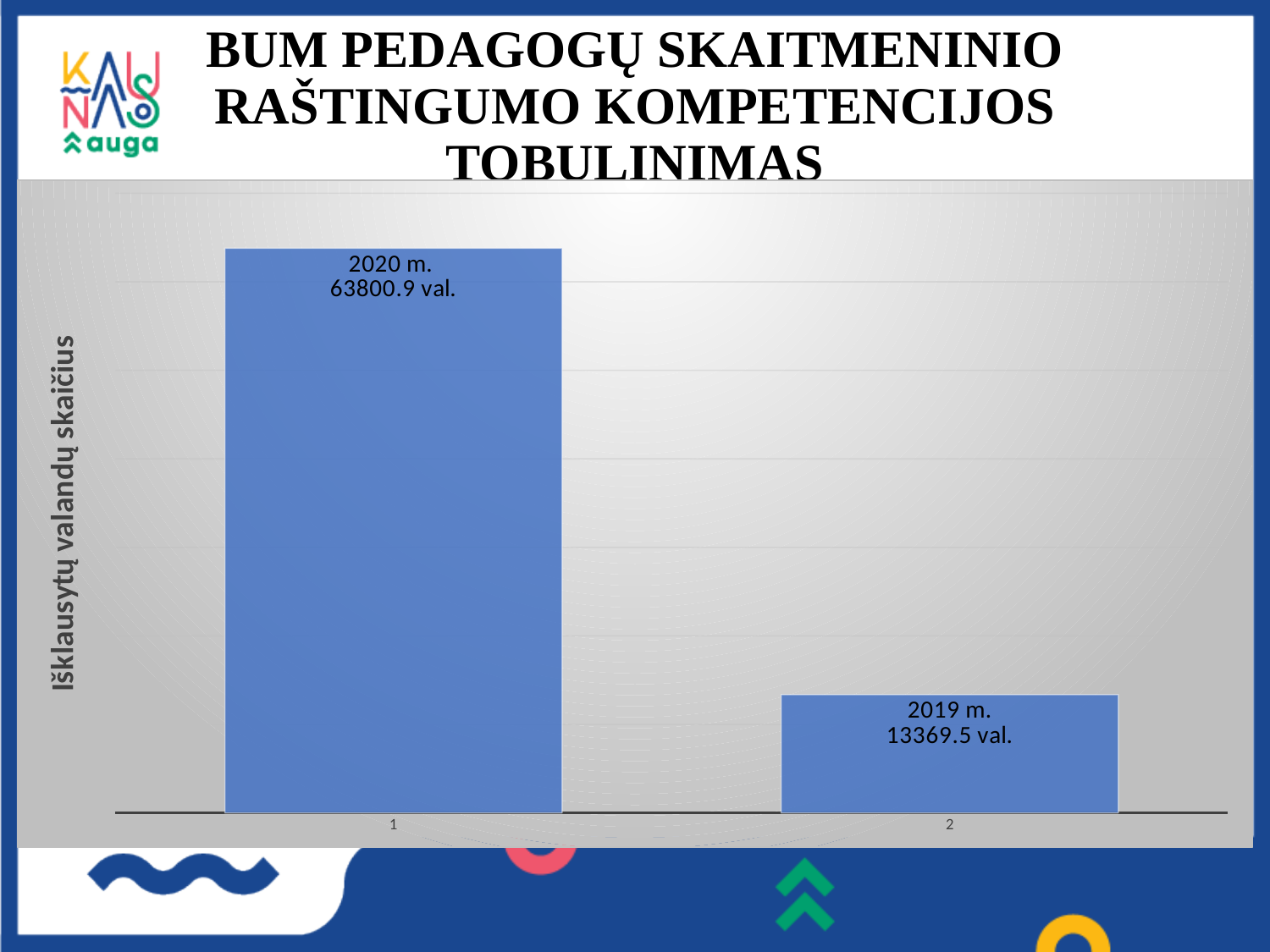
What is the label of the vertical axis? Išklausytų valandų skaičius Which is larger, the value for 2020 m. or the value for 2019 m.? 2020 m. Which year has the highest number of hours listened? 2020 m. What colour are the bars in the chart? Blue What is the value shown for 2019 m.? 13369.5 val. How many bars are plotted in the chart? 2 What is the value shown for 2020 m.? 63800.9 val. What kind of chart is shown on the slide? Bar chart Which year has the lowest number of hours listened? 2019 m. What is the difference between the 2020 m. value and the 2019 m. value? 50431.4 val.